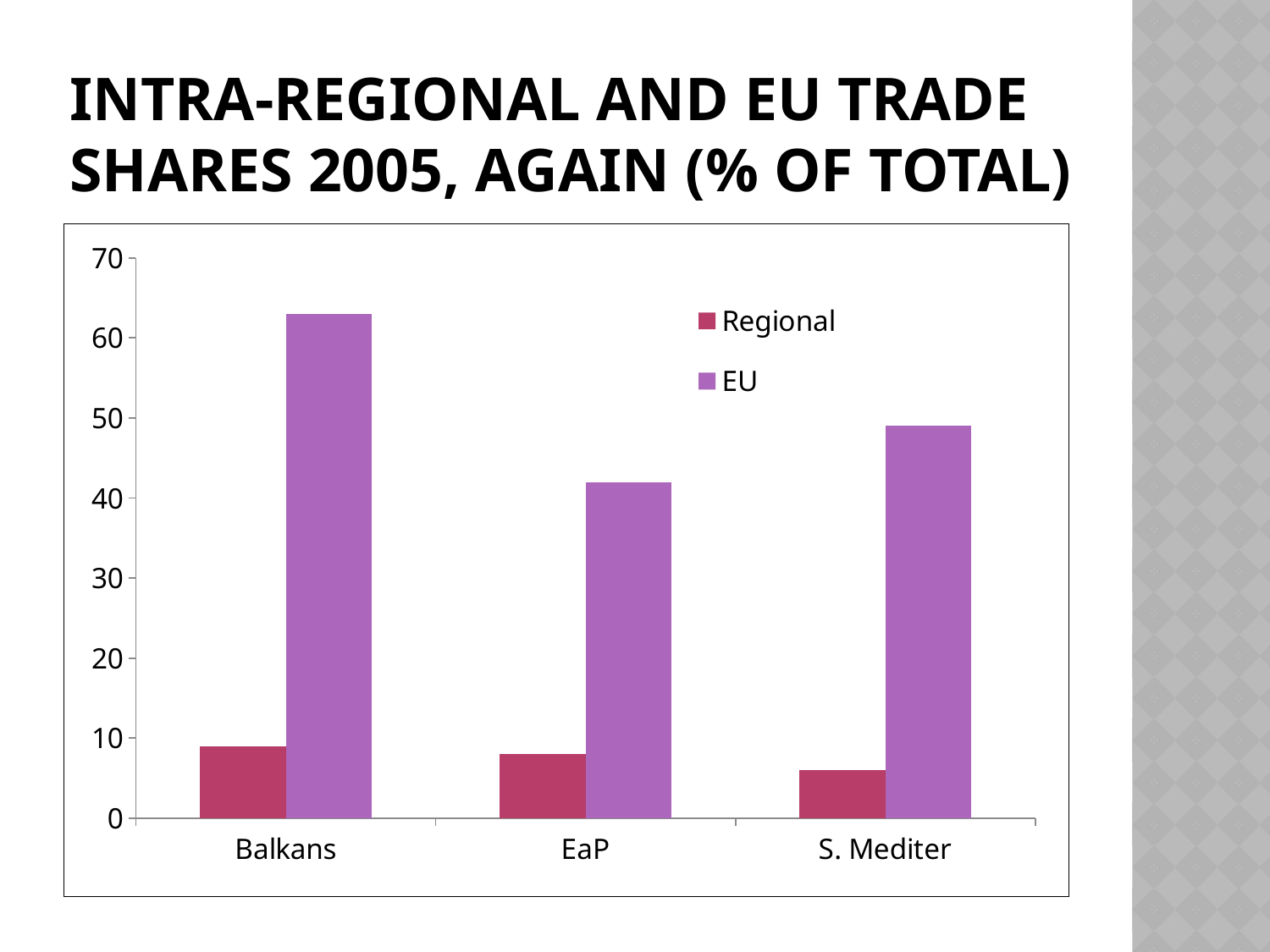
Which category has the lowest EU trade share? EaP How many categories are shown on the x axis? 3 What kind of chart is shown on the slide? bar chart What are the two series named in the legend? Regional and EU Which is larger, the EU share for Balkans or the EU share for S. Mediter? Balkans Is the EU value for Balkans greater or less than 60? greater For EaP, which is larger, the Regional share or the EU share? EU Is the Regional value for S. Mediter greater or less than 10? less How many series does the legend list? 2 Is the EU value for EaP greater or less than 40? greater Which category has the highest EU trade share? Balkans